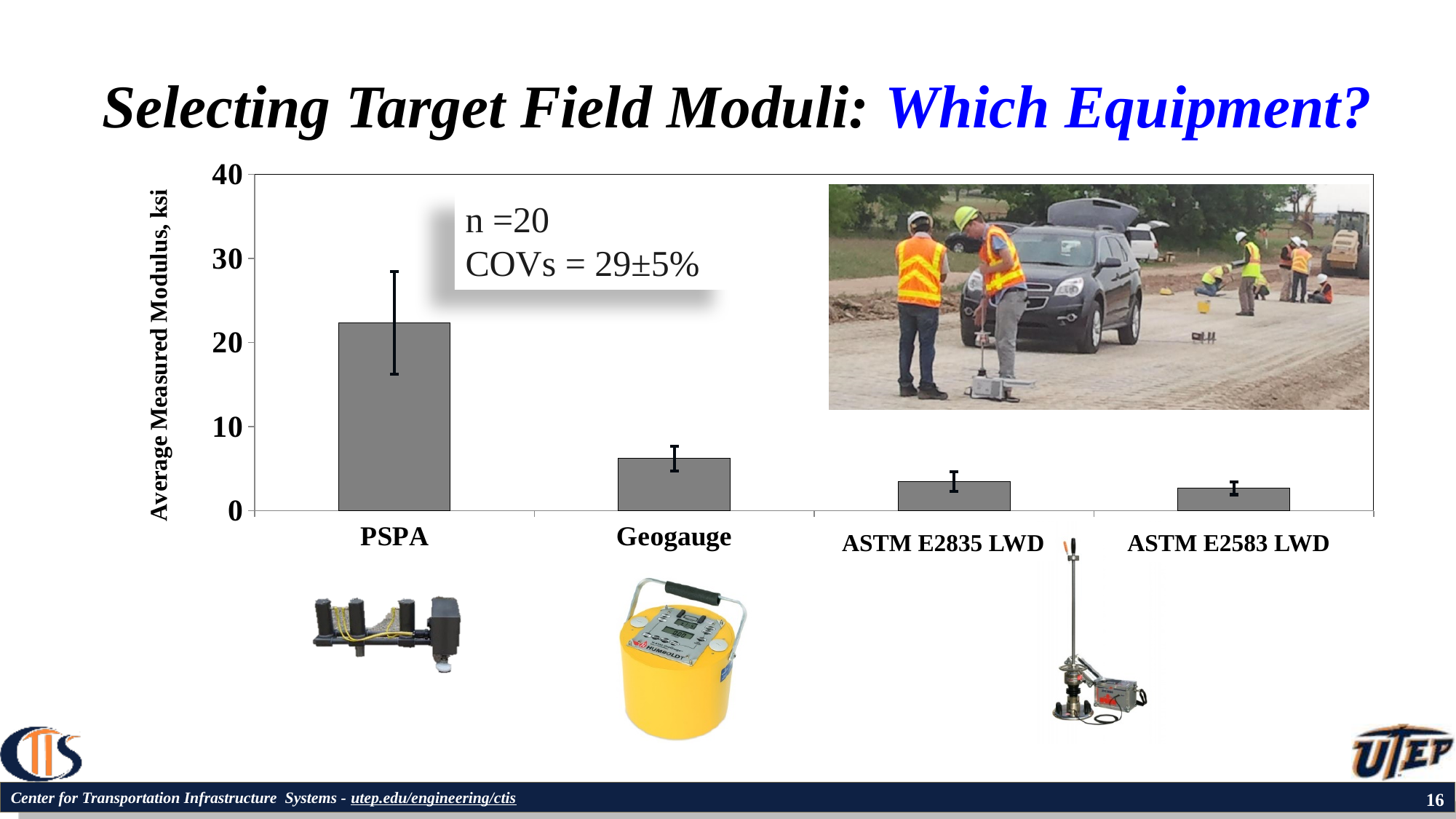
Is the average measured modulus for PSPA greater or less than 30 ksi? less Is the average measured modulus for PSPA greater or less than 20 ksi? greater Is the average measured modulus for ASTM E2835 LWD greater or less than 10 ksi? less Which has a larger average measured modulus, PSPA or Geogauge? PSPA What sample size n is stated in the annotation on the chart? 20 What kind of chart is shown on the slide? bar chart Which equipment has the highest average measured modulus in the chart? PSPA How many equipment categories are plotted on the x axis of the chart? 4 Do the bar values rise or fall moving from left to right along the x axis? fall What is the label of the y axis of the chart? Average Measured Modulus, ksi Which has a larger average measured modulus, Geogauge or ASTM E2583 LWD? Geogauge